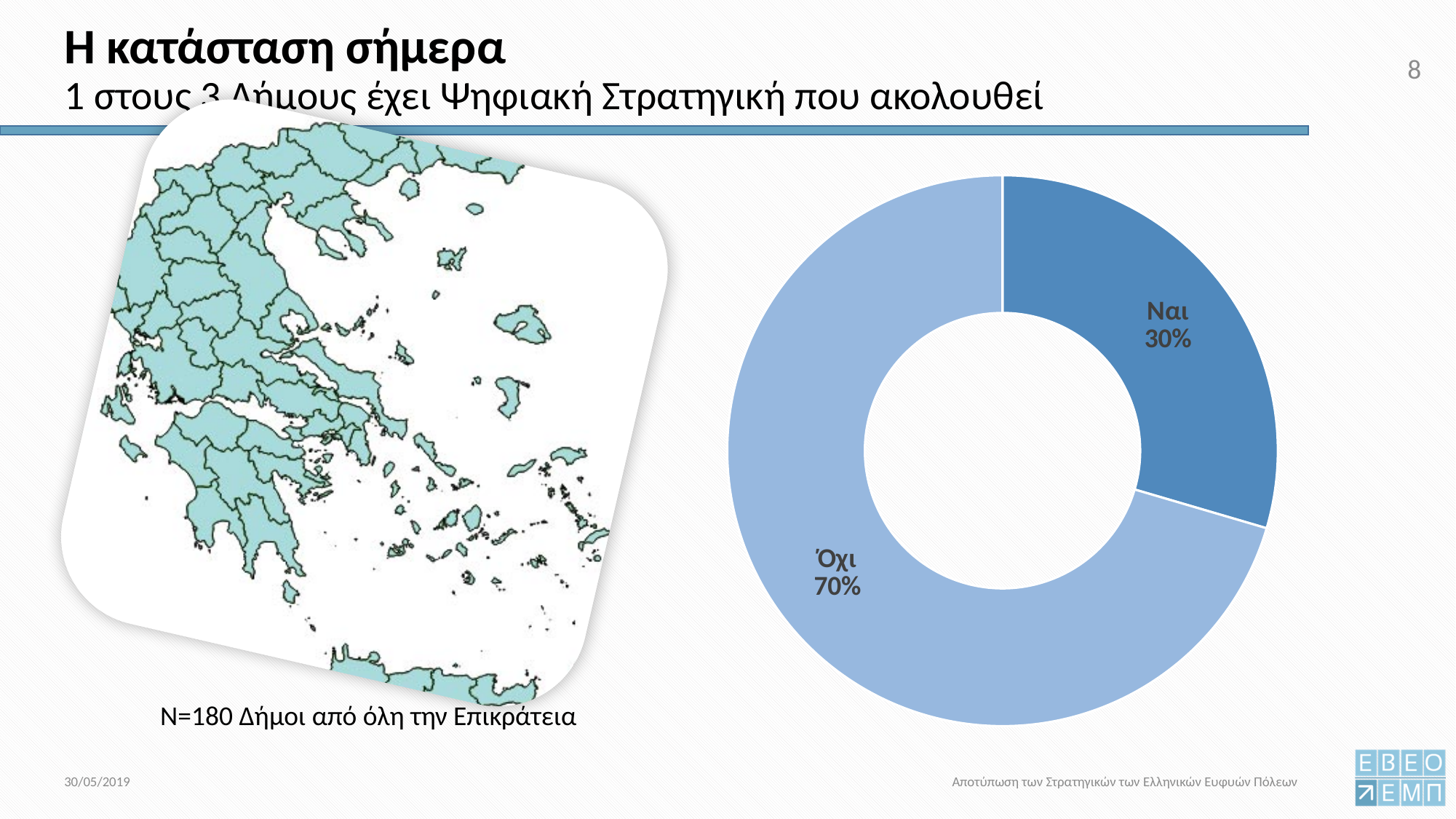
What share of the chart does the Ναι slice represent? 30% What percentage of the doughnut chart is labelled Όχι? 70% Which slice of the doughnut chart is drawn in the darker blue? Ναι What percentage of the doughnut chart is labelled Ναι? 30% What kind of chart is shown on the right of the slide? Doughnut chart What sample size (N) is stated on the slide for the chart? N=180 What is the difference in percentage points between the Όχι and Ναι slices? 40 What is the total of the two slices in the doughnut chart? 100% Which slice is larger, Ναι or Όχι? Όχι Which slice of the doughnut chart is the smallest? Ναι How many slices does the doughnut chart have? 2 Which slice of the doughnut chart is the largest? Όχι